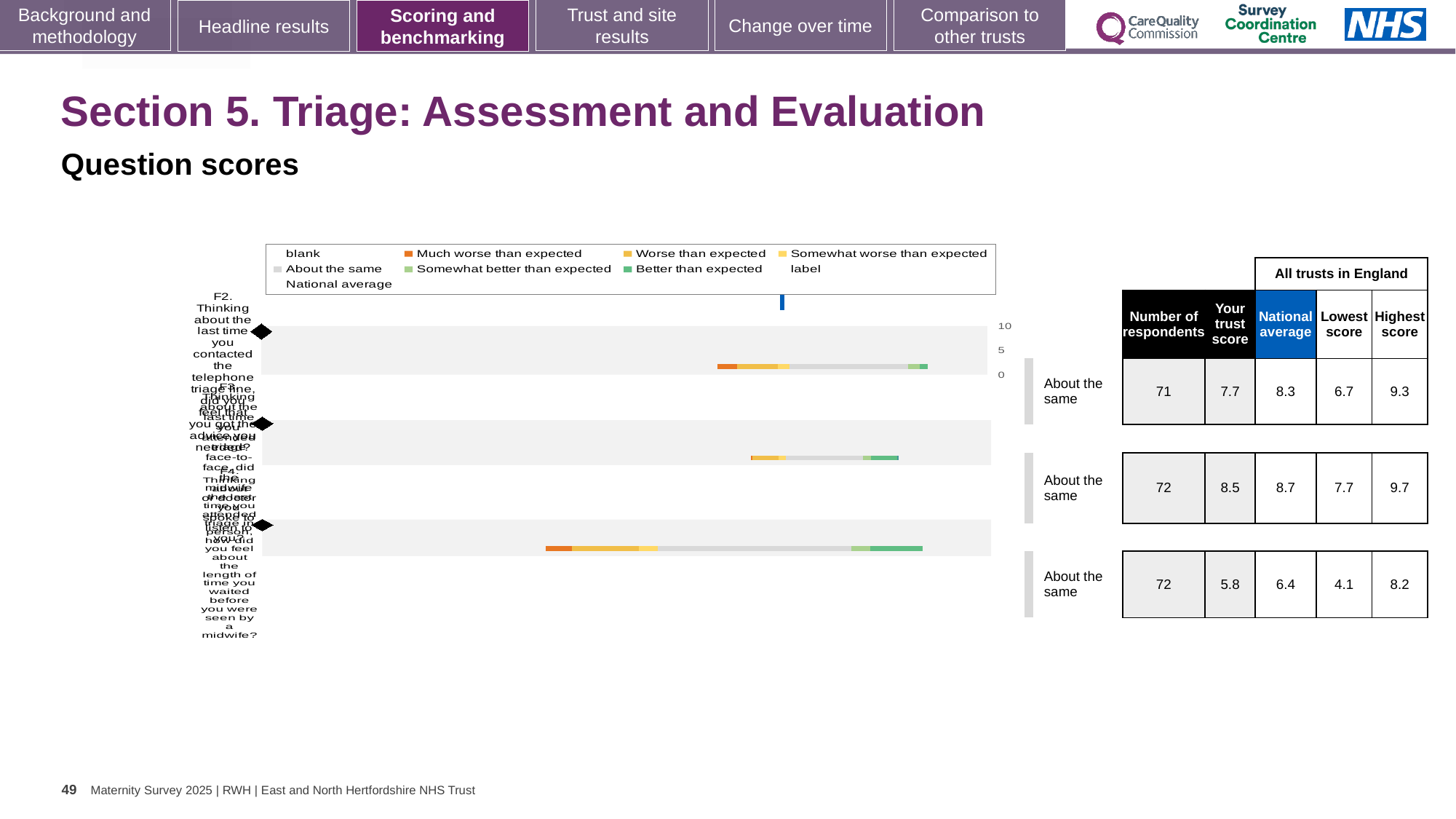
Which legend entry is shown in orange on the chart? Much worse than expected What kind of chart is shown on the slide? bar chart In the table beside the chart, what is the 'Your trust score' for the top row? 7.7 How many question rows (bars) does the chart show? 3 In the table beside the chart, which row has the lowest 'Your trust score'? the bottom row (5.8) In the table beside the chart, what is the national average for the top row? 8.3 In the table beside the chart, what is the difference between the highest score and the lowest score for the bottom row? 4.1 In the table beside the chart, which row has the highest 'Highest score'? the middle row (9.7) In the table beside the chart, what is the lowest score for the bottom row? 4.1 What is the highest value shown on the chart's numeric axis? 10 In the table beside the chart, what is the number of respondents for the bottom row? 72 In the table beside the chart, is the trust score for the middle row larger or smaller than its national average? smaller